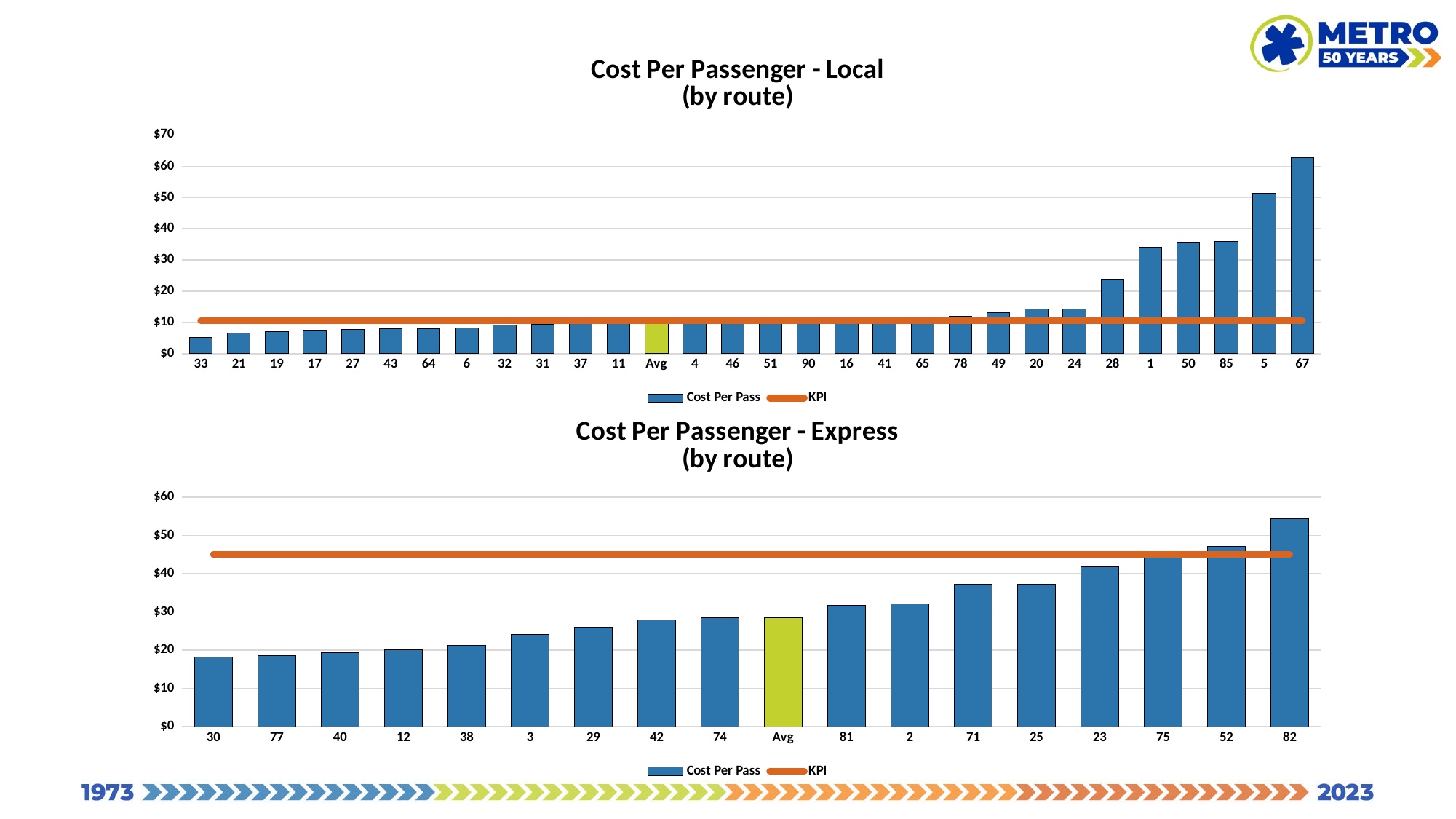
In the 'Cost Per Passenger - Express (by route)' chart, is the value for route 82 greater or less than $50? greater In the 'Cost Per Passenger - Local (by route)' chart, which route has the lowest cost per passenger? 33 In the 'Cost Per Passenger - Express (by route)' chart, which route has the highest cost per passenger? 82 In the 'Cost Per Passenger - Local (by route)' chart, is the value for route 28 greater or less than $20? greater How many entries does the legend of the 'Cost Per Passenger - Local (by route)' chart list? 2 In the 'Cost Per Passenger - Local (by route)' chart, which route has the highest cost per passenger? 67 In the 'Cost Per Passenger - Local (by route)' chart, is the value for route 67 greater or less than $60? greater In the 'Cost Per Passenger - Express (by route)' chart, which has the higher cost per passenger, route 82 or route 52? 82 How many bars are plotted in the 'Cost Per Passenger - Express (by route)' chart? 18 In the 'Cost Per Passenger - Express (by route)' chart, which route has the lowest cost per passenger? 30 Do the bar values in the 'Cost Per Passenger - Express (by route)' chart rise or fall from left to right along the x axis? rise